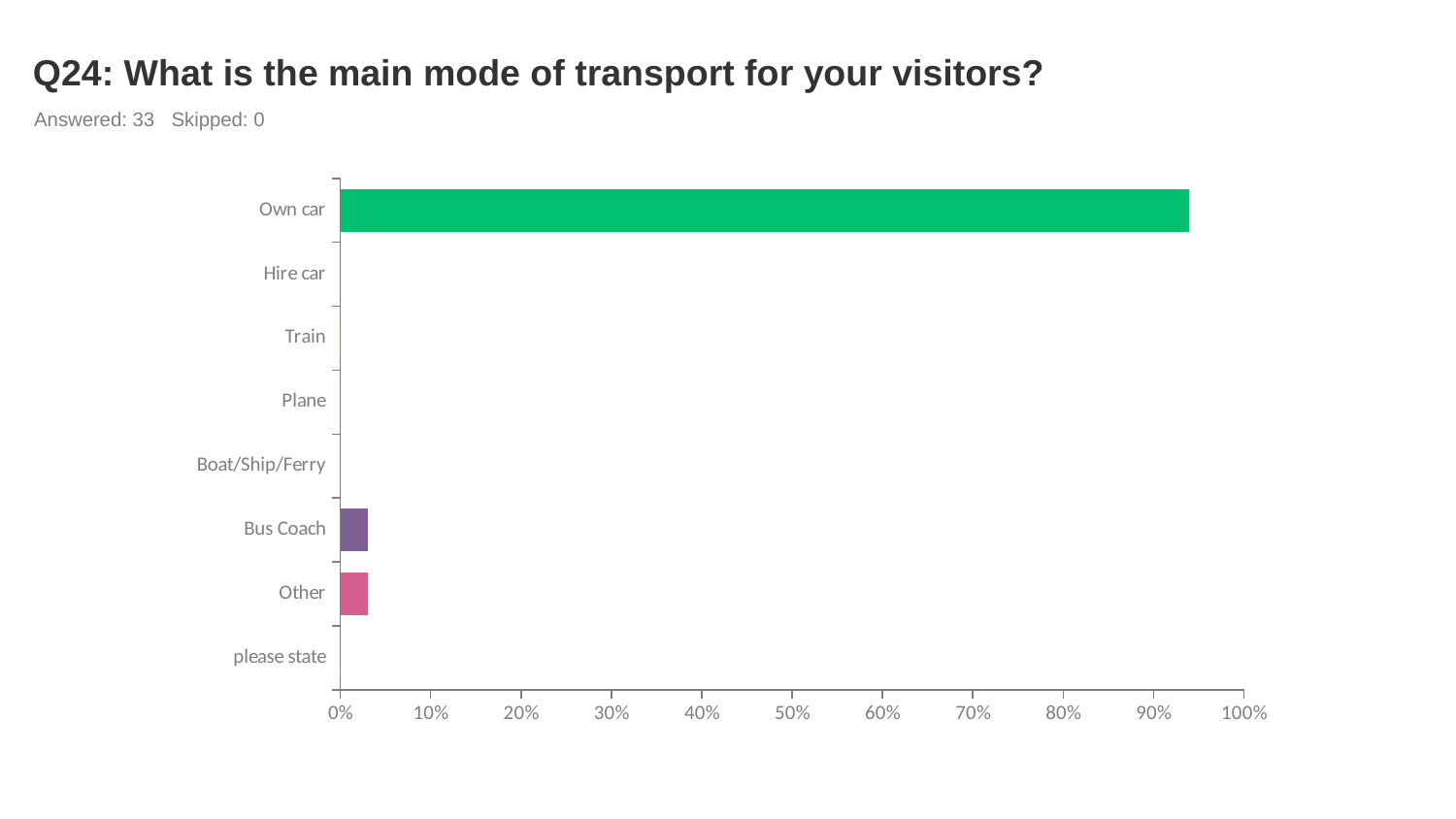
Is the value for Own car greater or less than 90%? greater Which is larger, the value for Own car or the value for Bus Coach? Own car Is the value for Bus Coach greater or less than 10%? less How many respondents answered the question according to the slide? 33 What is the title of the chart? Q24: What is the main mode of transport for your visitors? How many categories are shown on the y axis of the chart? 8 Which is larger, the value for Other or the value for Plane? Other What kind of chart is shown on the slide? bar chart Which mode of transport has the highest value? Own car What is the highest value shown on the x axis? 100% Is the value for Other greater or less than 10%? less